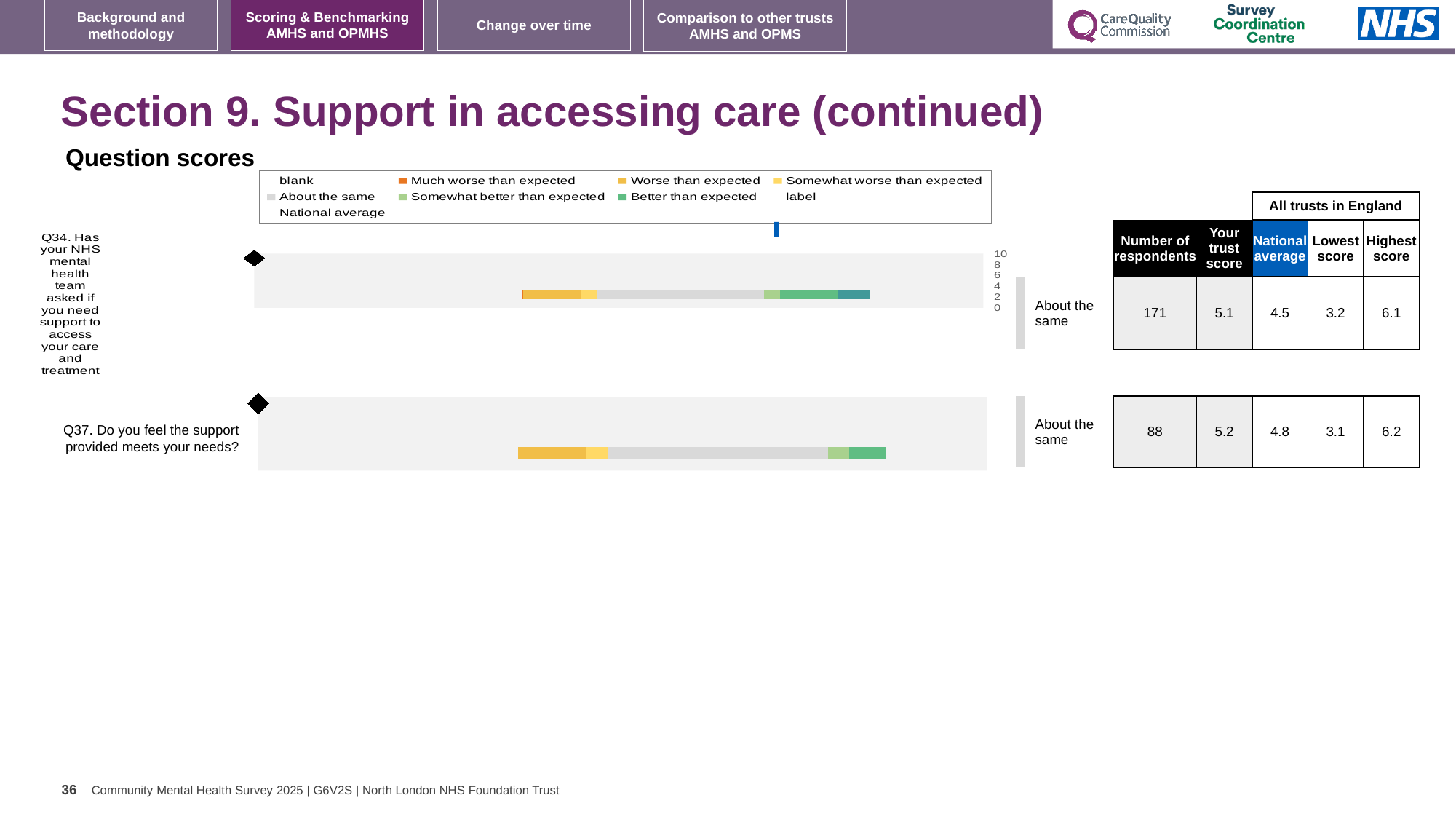
What is the difference between the highest score and the lowest score for Q34? 2.9 Which legend entry is shown in grey? About the same What kind of chart is used to show the question scores for Q34 and Q37? bar chart What is the trust score for Q34 in the table beside the chart? 5.1 What is the difference between the trust score and the national average for Q34? 0.6 Which question has the higher trust score, Q34 or Q37? Q37 How many respondents answered Q37? 88 How many questions are plotted as bars on the slide? 2 What is the national average for Q37 in the table beside the chart? 4.8 What benchmark category is shown next to the bar for Q34? About the same What benchmark category is shown next to the bar for Q37? About the same How many entries does the legend above the bars list? 9